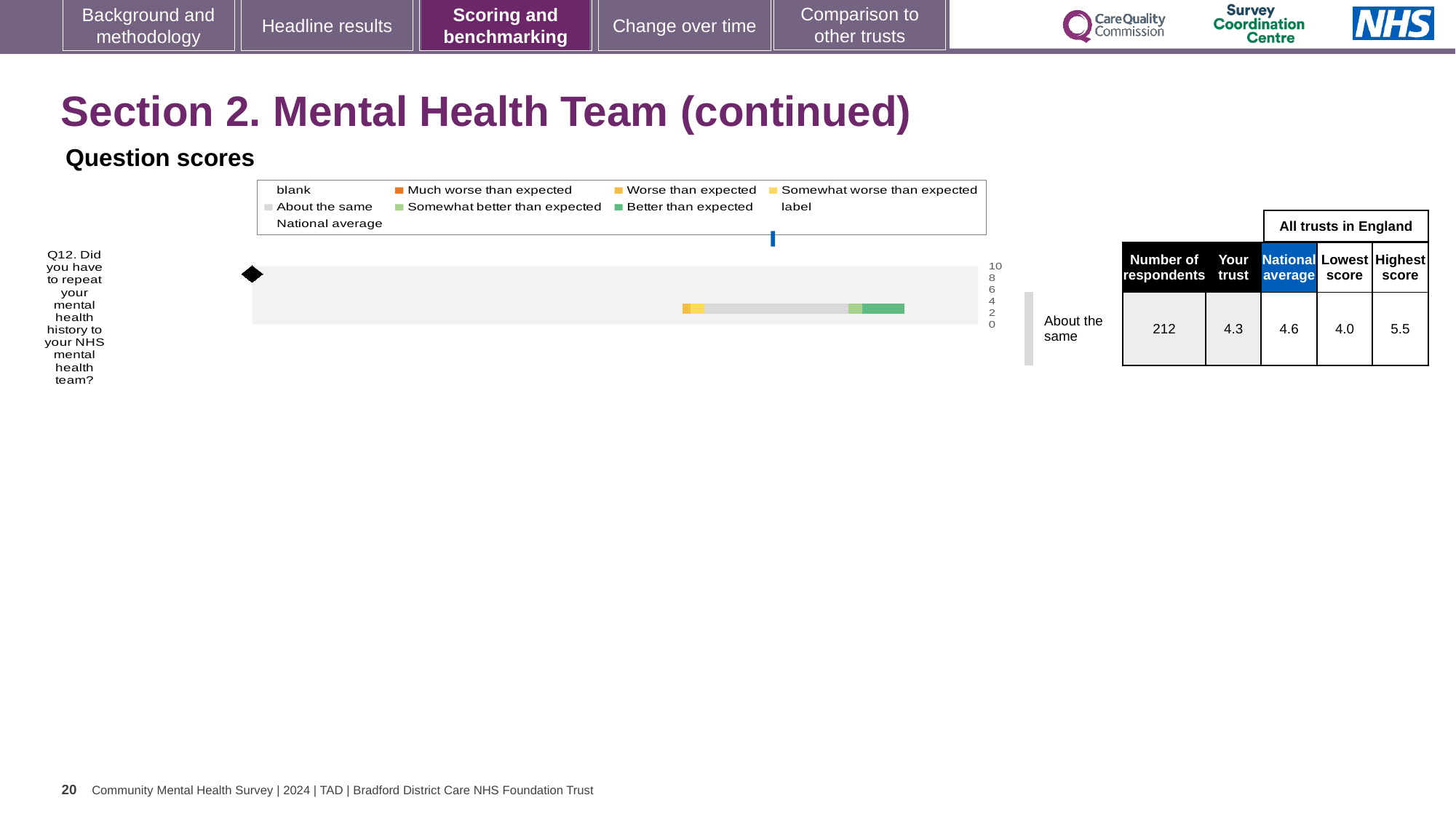
Is the 'Your trust' score for Q12 higher or lower than the national average? lower What is the national average score for Q12? 4.6 What is the difference between the highest and lowest scores for Q12 across all trusts in England? 1.5 What colour does the legend use for 'Much worse than expected'? orange What kind of chart is used to show the Q12 question score? bar chart How many survey questions are plotted on the chart? 1 What colour does the legend use for 'Better than expected'? green How many respondents answered Q12? 212 Which benchmark category is the trust's Q12 score placed in? About the same What is the lowest score among all trusts in England for Q12? 4.0 What is the highest score among all trusts in England for Q12? 5.5 What is the 'Your trust' score for Q12? 4.3